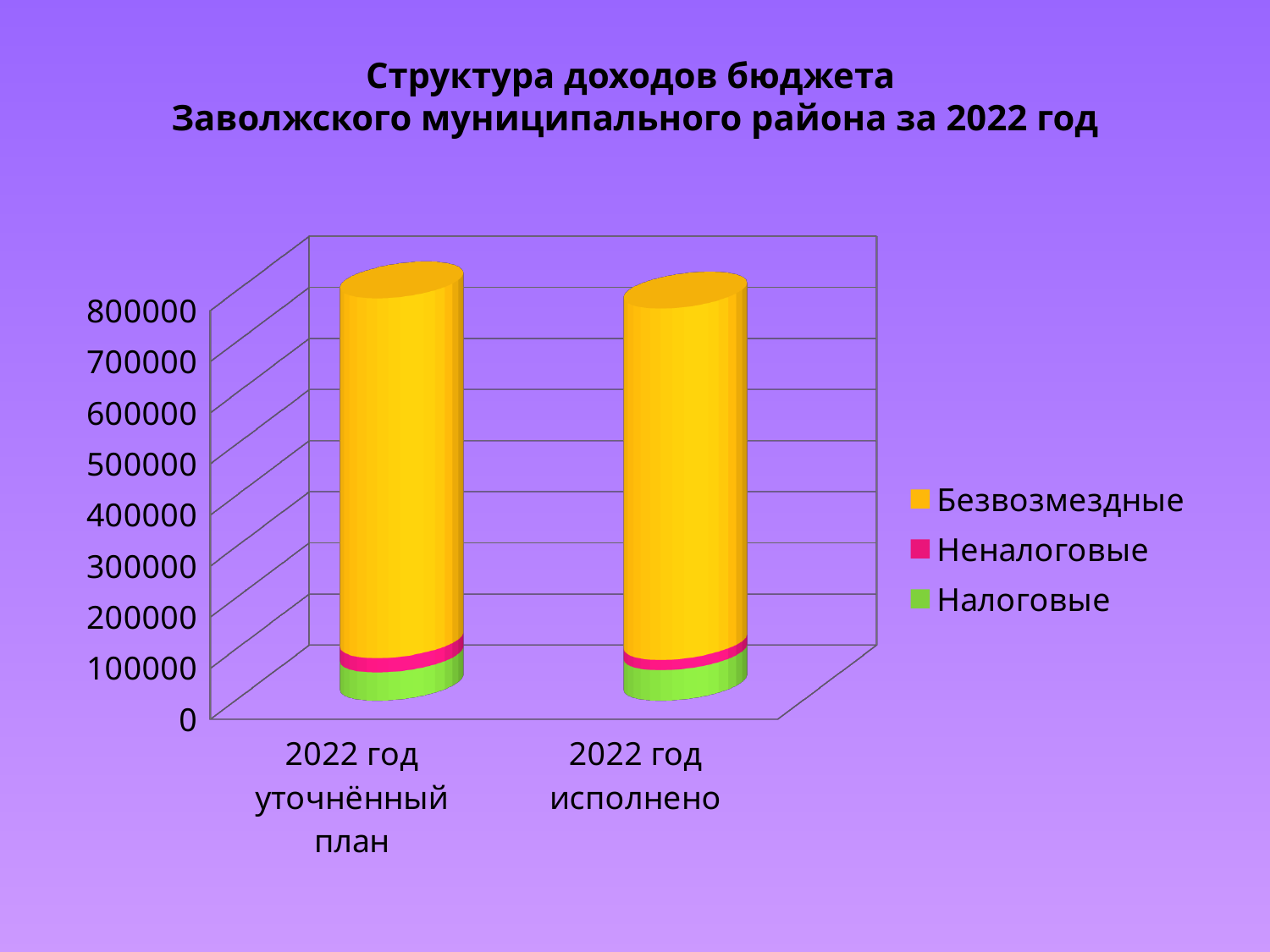
How many series does the legend list? 3 Is the Безвозмездные value for "2022 год исполнено" greater or less than 400000? greater How many categories are shown on the x axis? 2 Is the total height of the bar for "2022 год уточнённый план" greater or less than 500000? greater What is the title of the chart? Структура доходов бюджета Заволжского муниципального района за 2022 год Which series makes up the smallest part of the bar for "2022 год исполнено"? Неналоговые Is the Налоговые value for "2022 год исполнено" greater or less than 300000? less What kind of chart is shown on the slide? bar chart Which series makes up the largest part of the bar for "2022 год уточнённый план"? Безвозмездные What is the highest value labelled on the vertical axis? 800000 In the bar for "2022 год исполнено", which is larger: Налоговые or Неналоговые? Налоговые Which colour represents the Неналоговые series in the legend? pink